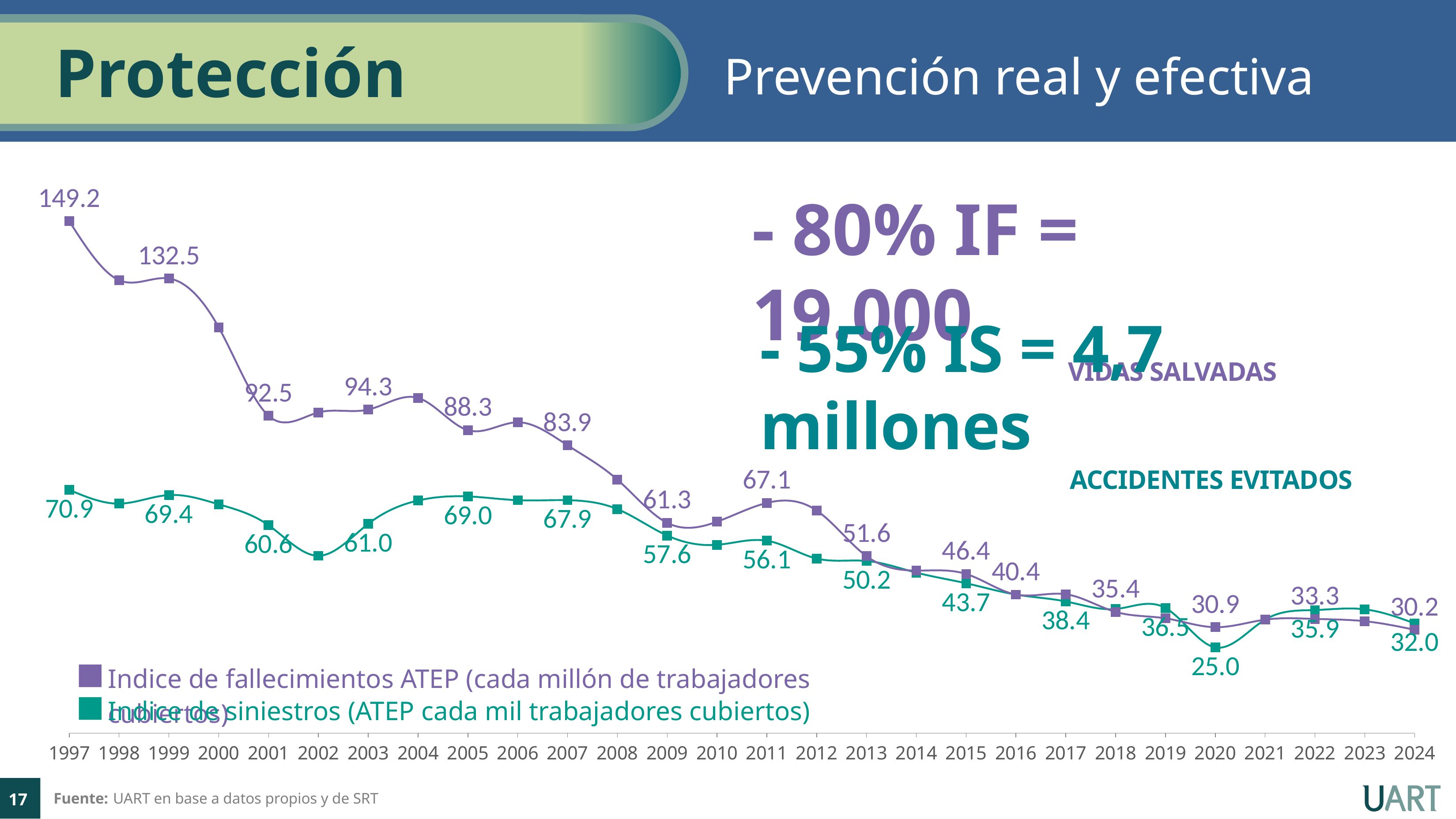
How many series does the legend list? 2 Does the Indice de fallecimientos ATEP series generally rise or fall from 1997 to 2024? Fall What is the value of the Indice de siniestros series in 1997? 70.9 What is the difference between the Indice de fallecimientos ATEP values in 1997 and 2024? 119.0 What kind of chart is shown on the slide? Line chart In which year is the Indice de fallecimientos ATEP series at its highest? 1997 What is the value of the Indice de siniestros series in 2020? 25.0 Which series has the larger value in 1997, Indice de fallecimientos ATEP or Indice de siniestros? Indice de fallecimientos ATEP What is the value of the Indice de fallecimientos ATEP series in 1997? 149.2 How many years are shown along the x axis? 28 In which year is the Indice de siniestros series at its lowest? 2020 What is the value of the Indice de fallecimientos ATEP series in 2024? 30.2